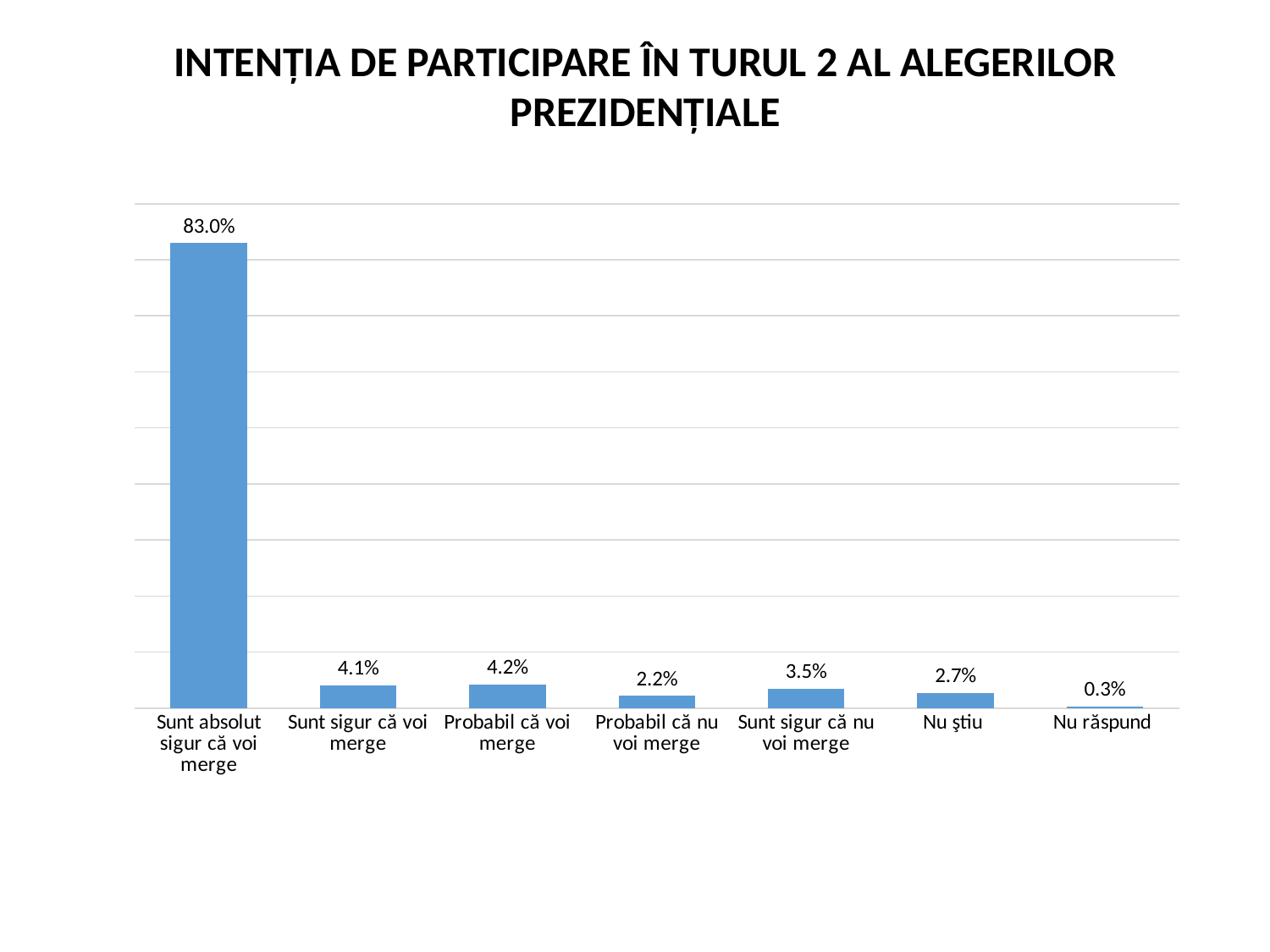
What is the difference between "Sunt sigur că nu voi merge" and "Probabil că nu voi merge"? 1.3% What is the difference between "Sunt absolut sigur că voi merge" and "Sunt sigur că voi merge"? 78.9% What is the title of the chart? INTENȚIA DE PARTICIPARE ÎN TURUL 2 AL ALEGERILOR PREZIDENȚIALE What is the value for "Probabil că nu voi merge"? 2.2% What is the value for "Nu ştiu"? 2.7% What is the value for "Nu răspund"? 0.3% Which is larger, "Sunt sigur că nu voi merge" or "Nu ştiu"? Sunt sigur că nu voi merge How many categories are shown on the x axis? 7 Which category has the highest value? Sunt absolut sigur că voi merge Which category has the lowest value? Nu răspund What is the value for "Sunt absolut sigur că voi merge"? 83.0% What kind of chart is shown on the slide? Bar chart